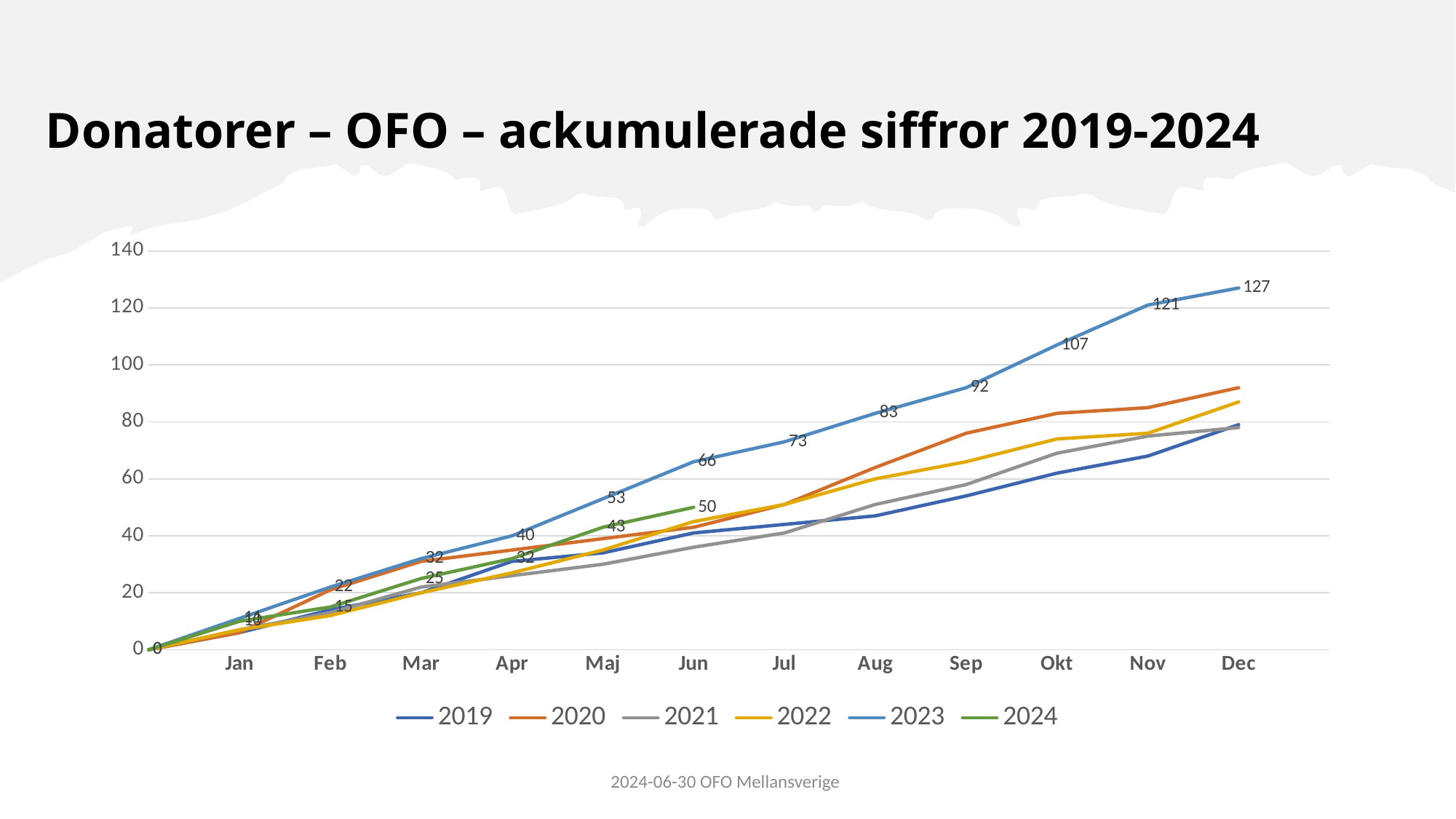
Which is larger in Maj, the value for 2023 or for 2024? 2023 What is the value for 2024 in Jun? 50 How many series does the legend list? 6 What is the difference between the 2023 values for Dec and Nov? 6 What is the value for 2024 in Mar? 25 What is the value for 2023 in Dec? 127 What is the value for 2023 in Okt? 107 What is the difference between the 2023 and 2024 values in Jun? 16 What kind of chart is shown on the slide? line chart Is the value for 2020 in Dec greater or less than 100? less Which series has the highest value in Dec? 2023 Do the values for 2023 rise or fall from Jan to Dec? rise